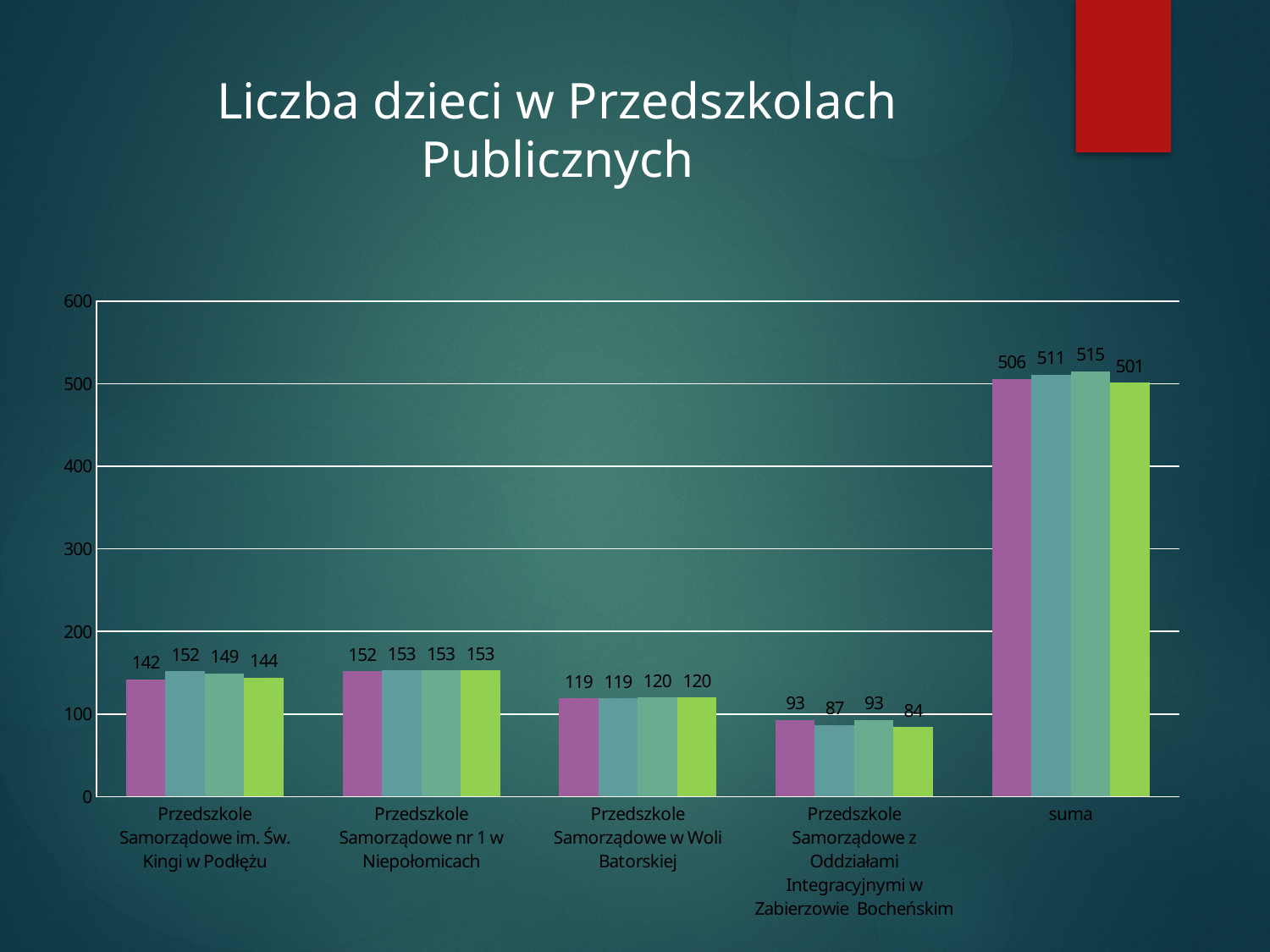
What is the value of the first (purple) bar for Przedszkole Samorządowe im. Św. Kingi w Podłężu? 142 Which category has the lowest values overall? Przedszkole Samorządowe z Oddziałami Integracyjnymi w Zabierzowie Bocheńskim What is the title of the chart? Liczba dzieci w Przedszkolach Publicznych How many bars are plotted for each category? 4 What is the value of the last (green) bar for Przedszkole Samorządowe z Oddziałami Integracyjnymi w Zabierzowie Bocheńskim? 84 Which category has the highest values overall? suma Is the value of the second bar for Przedszkole Samorządowe w Woli Batorskiej greater or less than 200? less How many categories are shown on the x axis? 5 What kind of chart is shown on the slide? bar chart What is the value of the third bar for suma? 515 What is the difference between the first (purple) bar for suma and the first (purple) bar for Przedszkole Samorządowe nr 1 w Niepołomicach? 354 Which is larger: the first (purple) bar for Przedszkole Samorządowe im. Św. Kingi w Podłężu or the first (purple) bar for Przedszkole Samorządowe nr 1 w Niepołomicach? Przedszkole Samorządowe nr 1 w Niepołomicach